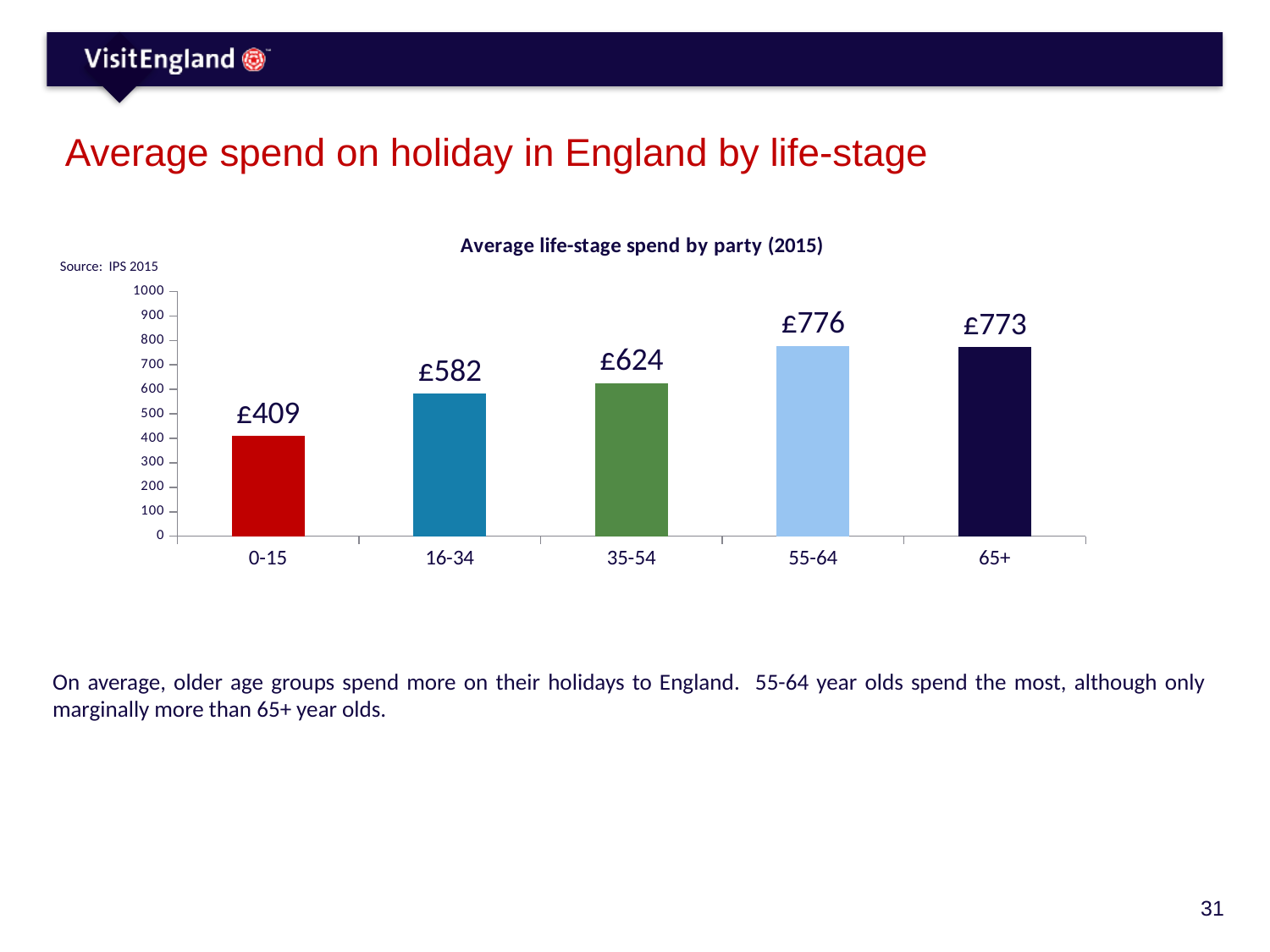
What is the average spend for the 0-15 age group? £409 Which age group has the lowest average spend? 0-15 How many age groups are shown in the chart? 5 What is the average spend for the 35-54 age group? £624 What is the title of the chart? Average life-stage spend by party (2015) Which age group has the highest average spend? 55-64 What is the difference in average spend between the 16-34 and 0-15 age groups? £173 Which age group has a higher average spend, 16-34 or 35-54? 35-54 What type of chart is shown on the slide? Bar chart What is the difference in average spend between the 55-64 and 35-54 age groups? £152 What is the average spend for the 65+ age group? £773 Is the average spend for the 16-34 age group greater or less than 500? greater